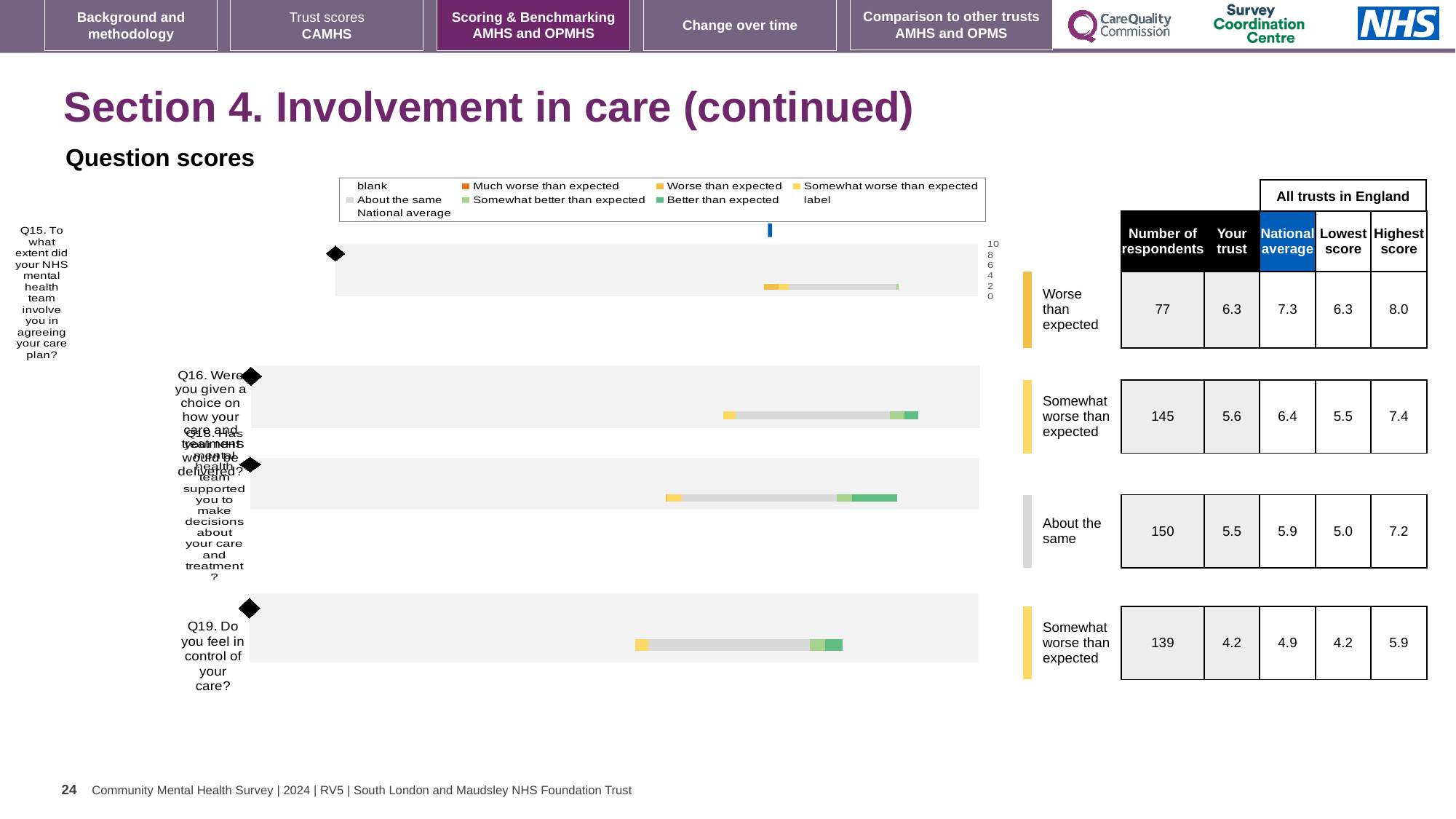
Which question has the highest 'Your trust' score? Q15 What is the 'Your trust' score for Q15 (involvement in agreeing your care plan)? 6.3 Which question has the lowest national average score? Q19 For Q16, how much higher is the national average than the 'Your trust' score? 0.8 What is the national average score for Q19 (Do you feel in control of your care?)? 4.9 How many survey questions are plotted in the question scores chart? 4 What is the difference between the highest score and the lowest score for Q15? 1.7 Which benchmark category is Q18 placed in? About the same What is the highest score among all trusts in England for Q16? 7.4 How many respondents answered Q18 (supported to make decisions about your care and treatment)? 150 What kind of chart is used to show the question scores on this slide? bar chart For Q18, which is larger: the 'Your trust' score or the national average? National average